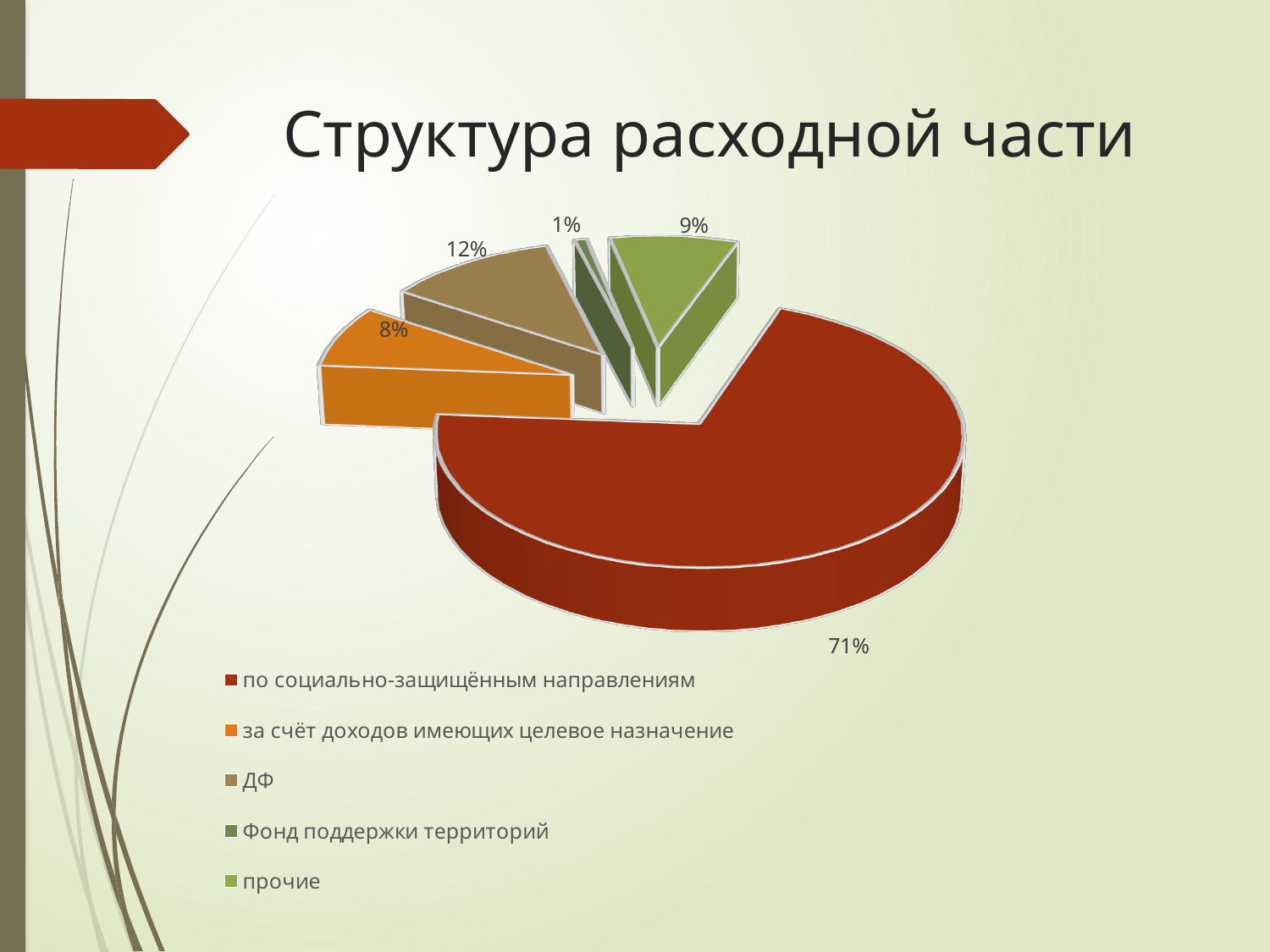
What share of the pie is 'прочие'? 9% How many entries does the legend list? 5 What share of the pie is 'ДФ'? 12% What kind of chart is shown on the slide? pie chart Which category has the largest share of the pie? по социально-защищённым направлениям What share of the pie is 'Фонд поддержки территорий'? 1% What is the difference between the shares of 'ДФ' and 'прочие'? 3% What is the title of the chart? Структура расходной части How many slices does the pie chart have? 5 Which category has the smallest share of the pie? Фонд поддержки территорий